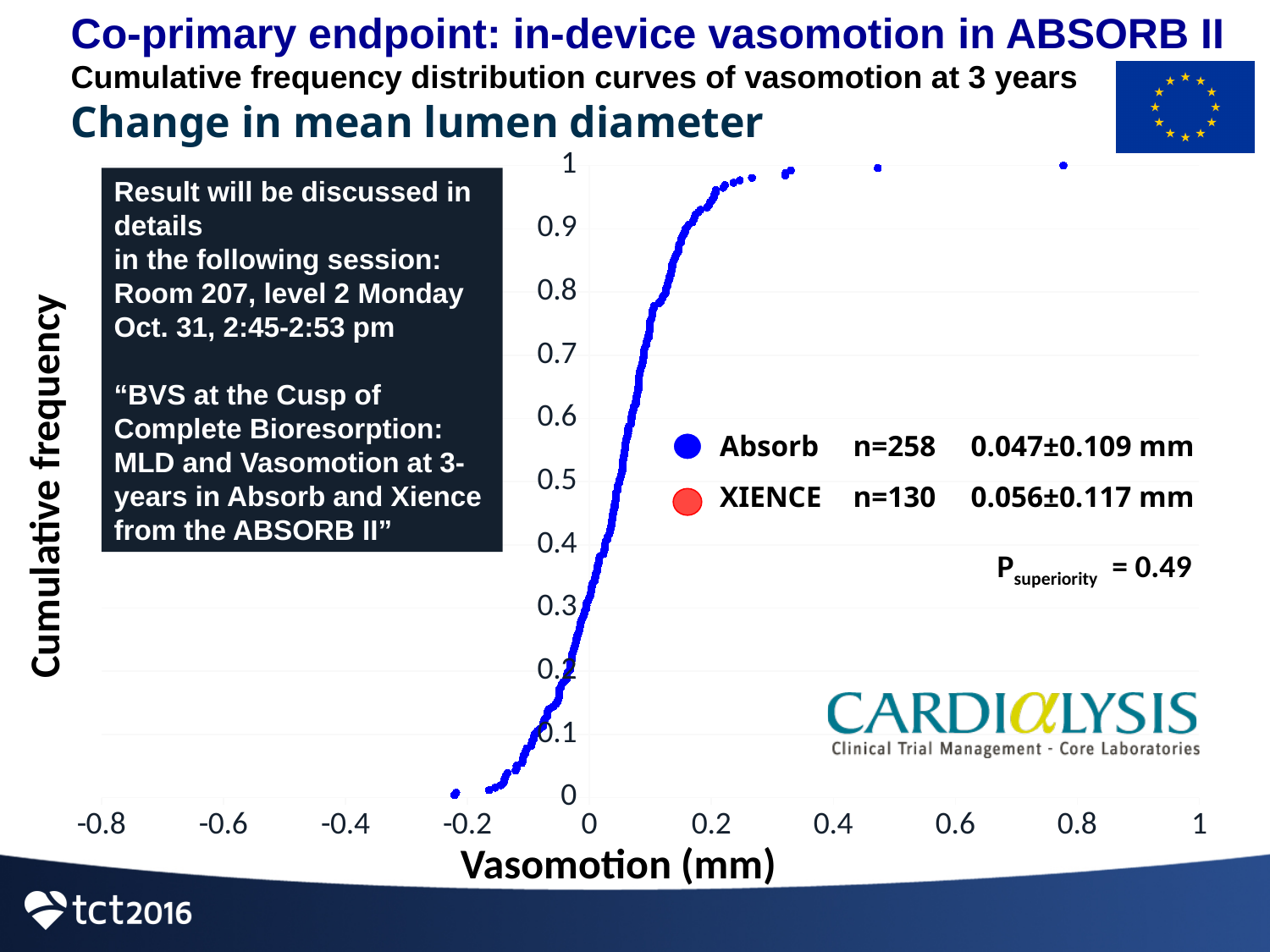
Does the cumulative frequency rise or fall as vasomotion increases along the x axis? Rise What is the P value for superiority shown on the chart? 0.49 Is the cumulative frequency of the Absorb curve at a vasomotion of 0 mm greater or less than 0.5? less What is the mean ± SD change in mean lumen diameter for XIENCE? 0.056±0.117 mm What is the sample size (n) for Absorb shown in the legend? n=258 What is the difference in sample size between Absorb and XIENCE? 128 Which group has the larger sample size, Absorb or XIENCE? Absorb What is the sample size (n) for XIENCE shown in the legend? n=130 What is the mean ± SD change in mean lumen diameter for Absorb? 0.047±0.109 mm What colour is used for the Absorb series in the legend? Blue What kind of chart is shown on the slide? Scatter plot (cumulative frequency distribution curve) How many series does the chart legend list? 2